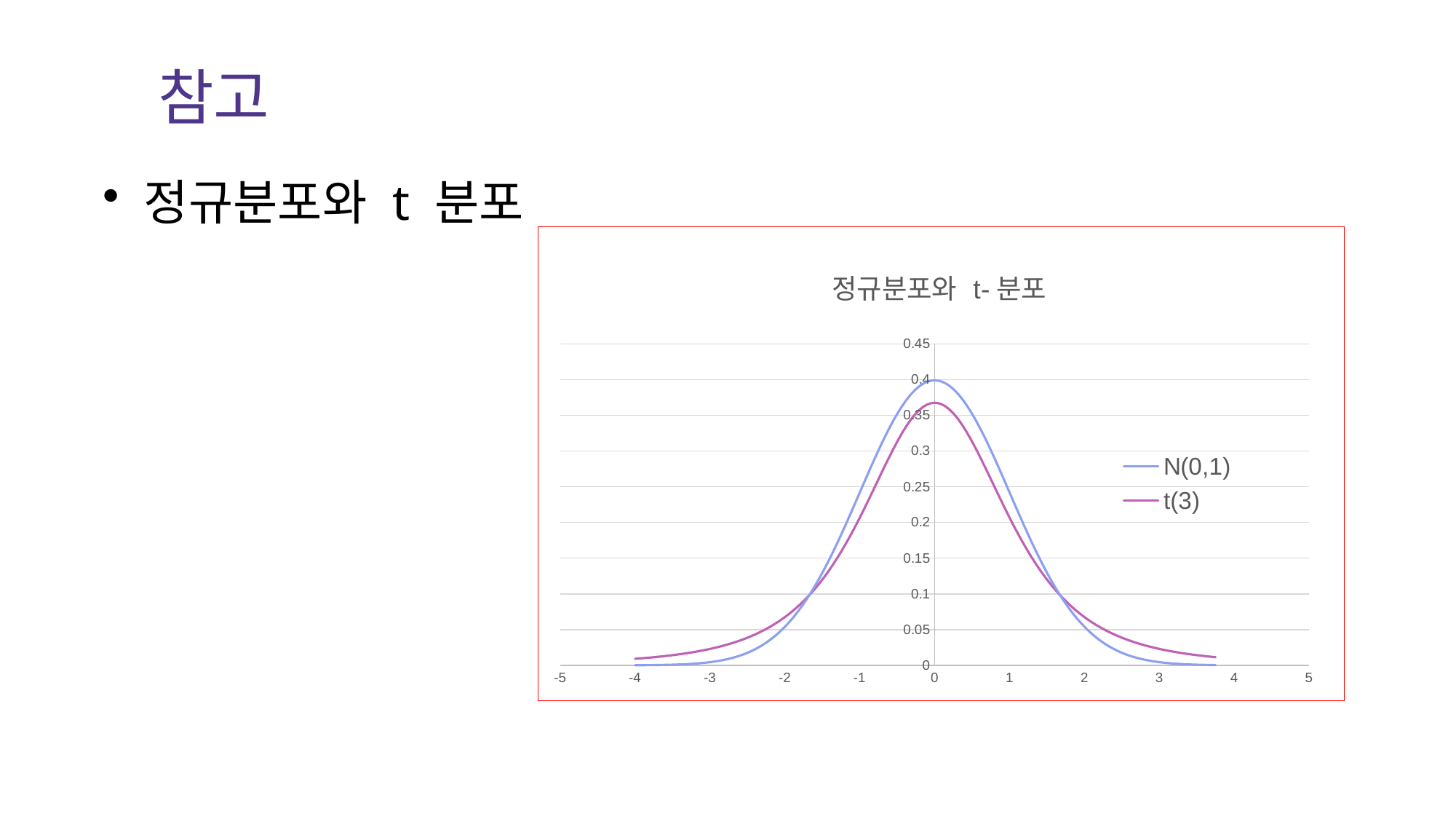
How many series does the legend list? 2 What kind of chart is shown on the slide? line chart Is the value of N(0,1) at x = 2 greater or less than 0.1? less At x = 3, which series has the larger value, N(0,1) or t(3)? t(3) Which series reaches the higher peak at x = 0, N(0,1) or t(3)? N(0,1) Do the values of N(0,1) rise or fall as x increases from 0 to 4? fall What is the highest value shown on the y axis? 0.45 Is the peak value of t(3) at x = 0 greater or less than 0.4? less What is the title of the chart? 정규분포와 t- 분포 At x = 1, which series has the larger value, N(0,1) or t(3)? N(0,1) Is the peak value of N(0,1) at x = 0 greater or less than 0.35? greater What are the two series named in the legend? N(0,1) and t(3)